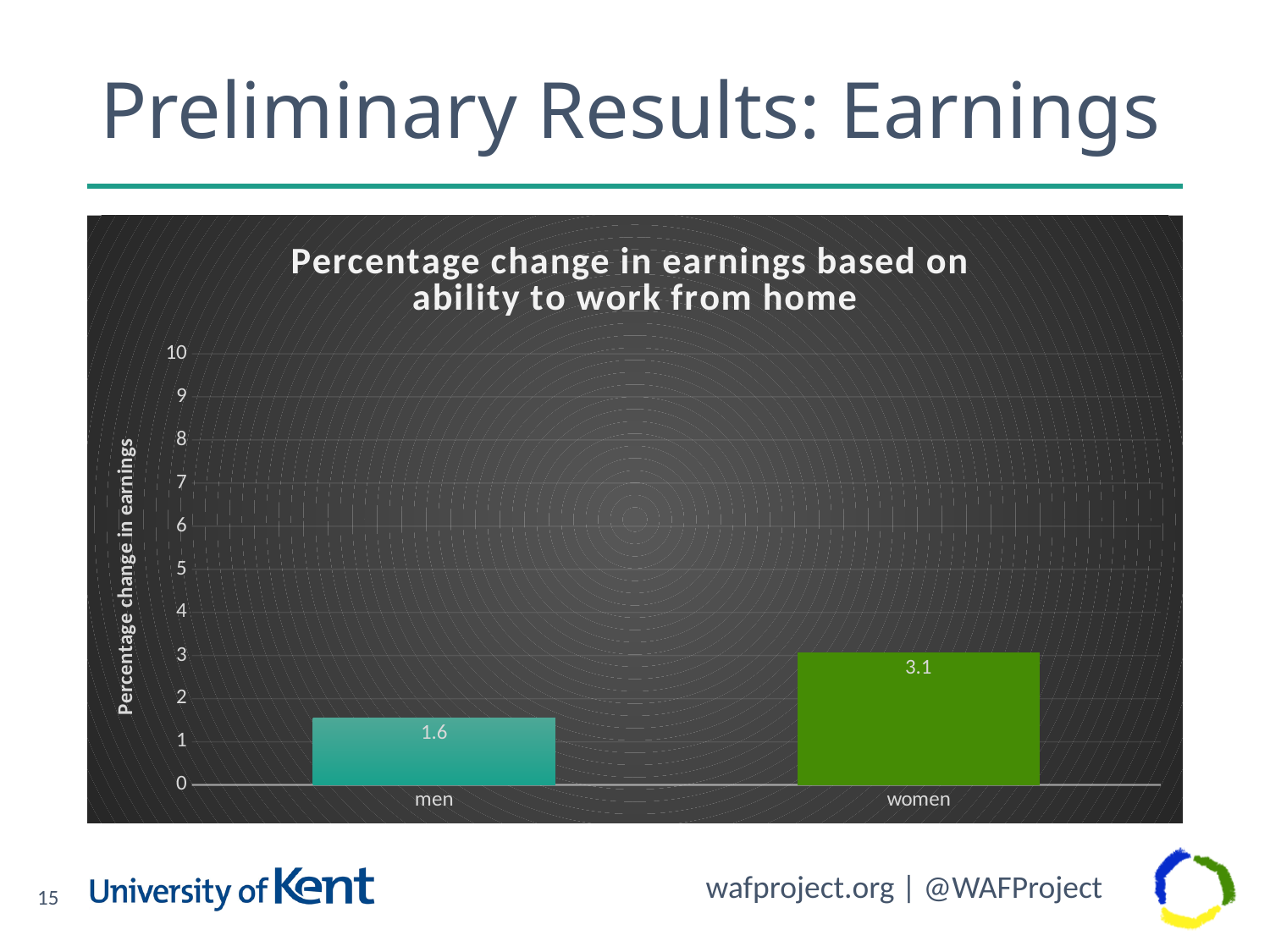
What is the title of the chart? Percentage change in earnings based on ability to work from home How many categories are shown on the x axis? 2 Which category has the higher percentage change in earnings? women What kind of chart is shown on the slide? bar chart What is the percentage change in earnings for men? 1.6 What is the label on the vertical axis? Percentage change in earnings Is the value for men greater or less than 2? less Is the value for men larger or smaller than the value for women? smaller What is the percentage change in earnings for women? 3.1 What is the difference between the values for women and men? 1.5 Is the value for women greater or less than 2? greater Which category has the lower percentage change in earnings? men